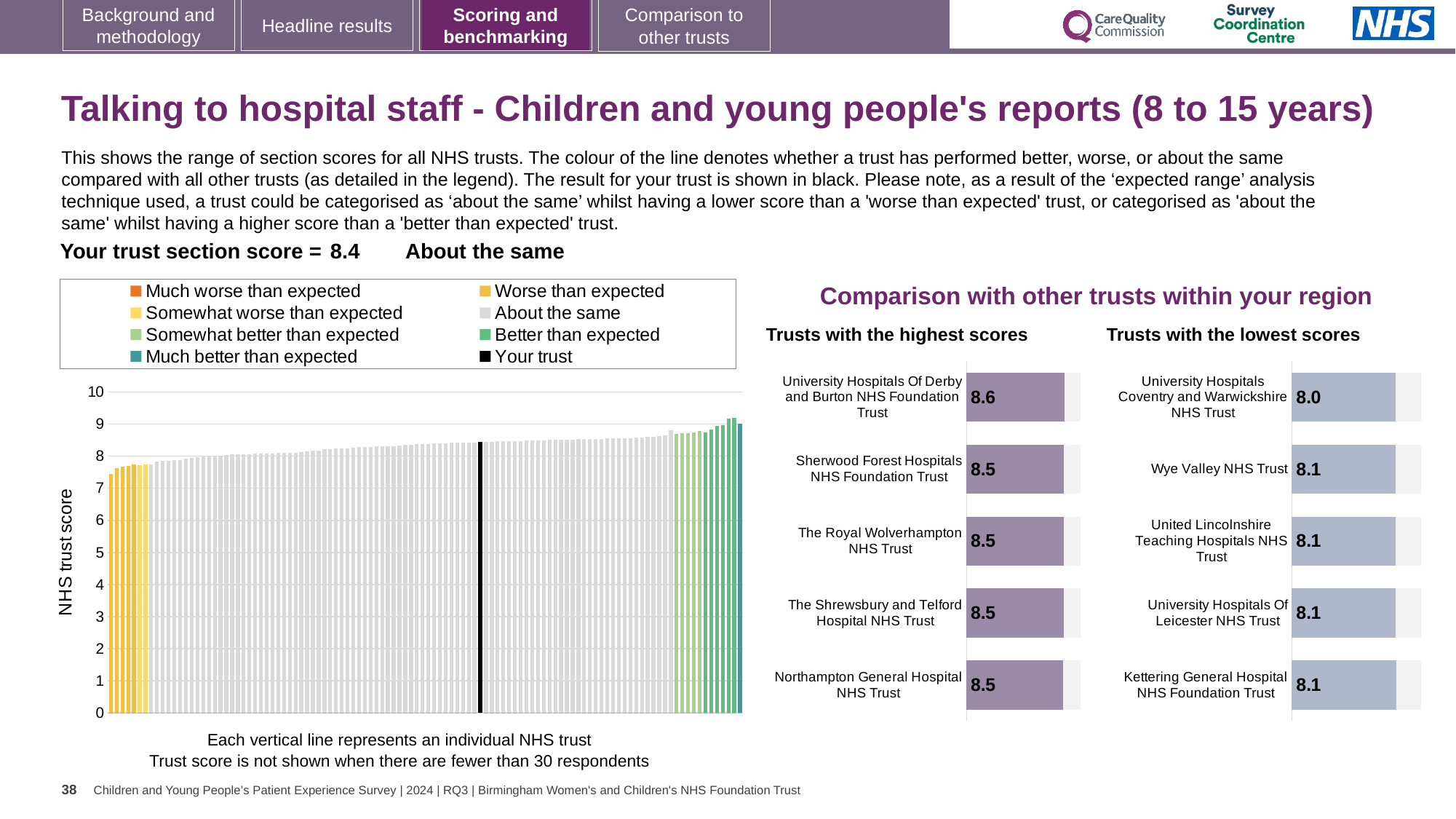
In the 'Trusts with the highest scores' chart, what is the score for University Hospitals Of Derby and Burton NHS Foundation Trust? 8.6 In the main chart on the left, what is the section score for your trust (the black bar)? 8.4 In the 'Trusts with the highest scores' chart, which trust has the highest score? University Hospitals Of Derby and Burton NHS Foundation Trust How many trusts are shown in the 'Trusts with the highest scores' chart? 5 How many entries does the legend of the main chart on the left list? 8 In the 'Trusts with the highest scores' chart, what is the difference between the scores of University Hospitals Of Derby and Burton NHS Foundation Trust and Sherwood Forest Hospitals NHS Foundation Trust? 0.1 Which is larger: the score for Kettering General Hospital NHS Foundation Trust in the lowest scores chart or the score for Northampton General Hospital NHS Trust in the highest scores chart? Northampton General Hospital NHS Trust In the 'Trusts with the lowest scores' chart, what is the score for Wye Valley NHS Trust? 8.1 What kind of chart is the main chart on the left of the slide? Bar chart In the main chart on the left, is the value of the leftmost (lowest) bar greater or less than 8? less In the 'Trusts with the lowest scores' chart, which trust has the lowest score? University Hospitals Coventry and Warwickshire NHS Trust In the 'Trusts with the lowest scores' chart, what is the score for University Hospitals Coventry and Warwickshire NHS Trust? 8.0